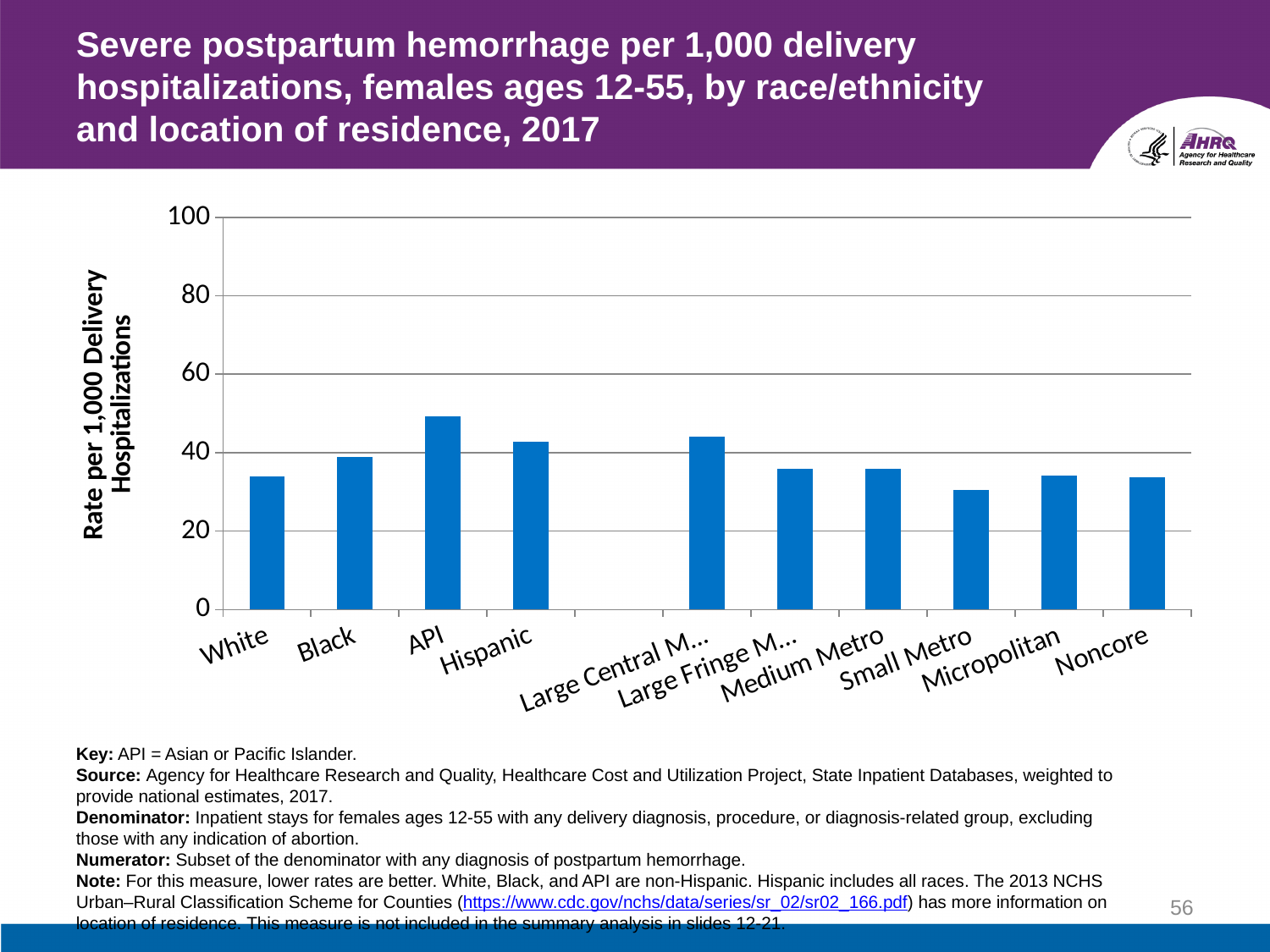
Is the value for Medium Metro greater or less than 40? less Is the value for Hispanic greater or less than 40? greater Which is larger, the value for API or the value for Hispanic? API Which category has the highest rate of severe postpartum hemorrhage? API What kind of chart is shown on the slide? Bar chart Is the value for API greater or less than 40? greater What is the label of the y axis of the chart? Rate per 1,000 Delivery Hospitalizations Which category has the lowest rate of severe postpartum hemorrhage? Small Metro Which is larger, the value for Black or the value for White? Black How many categories are plotted along the x axis of the chart? 10